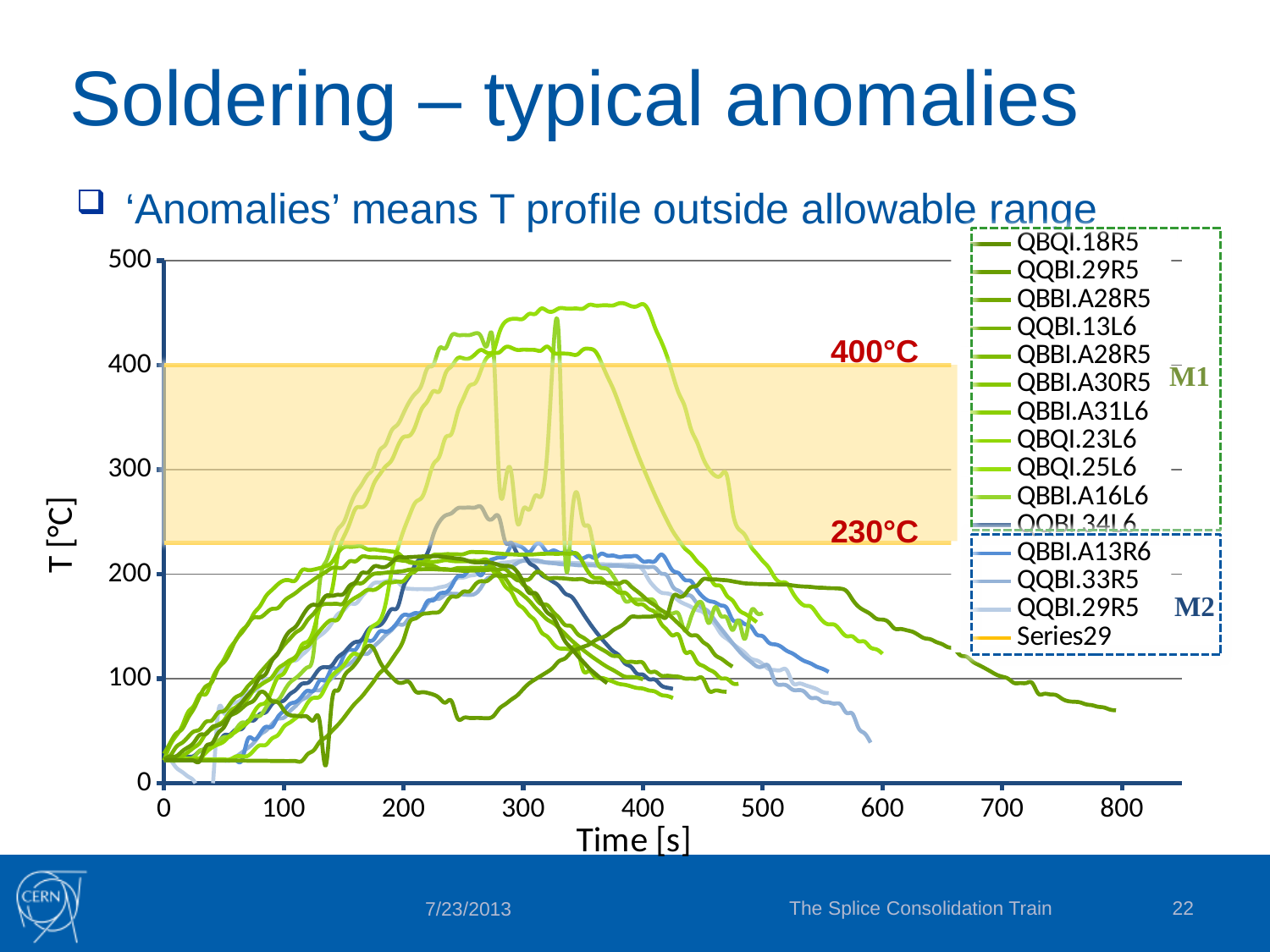
How many series does the chart's legend list? 15 Is the highest temperature reached by any line on the chart greater or less than 400? greater What kind of chart is shown on the slide? line chart What is the label of the x axis of the chart? Time [s] Is the temperature at which the lines start at time 0 greater or less than 100? less What are the lower and upper temperature limits marked on the shaded band in the chart? 230°C and 400°C